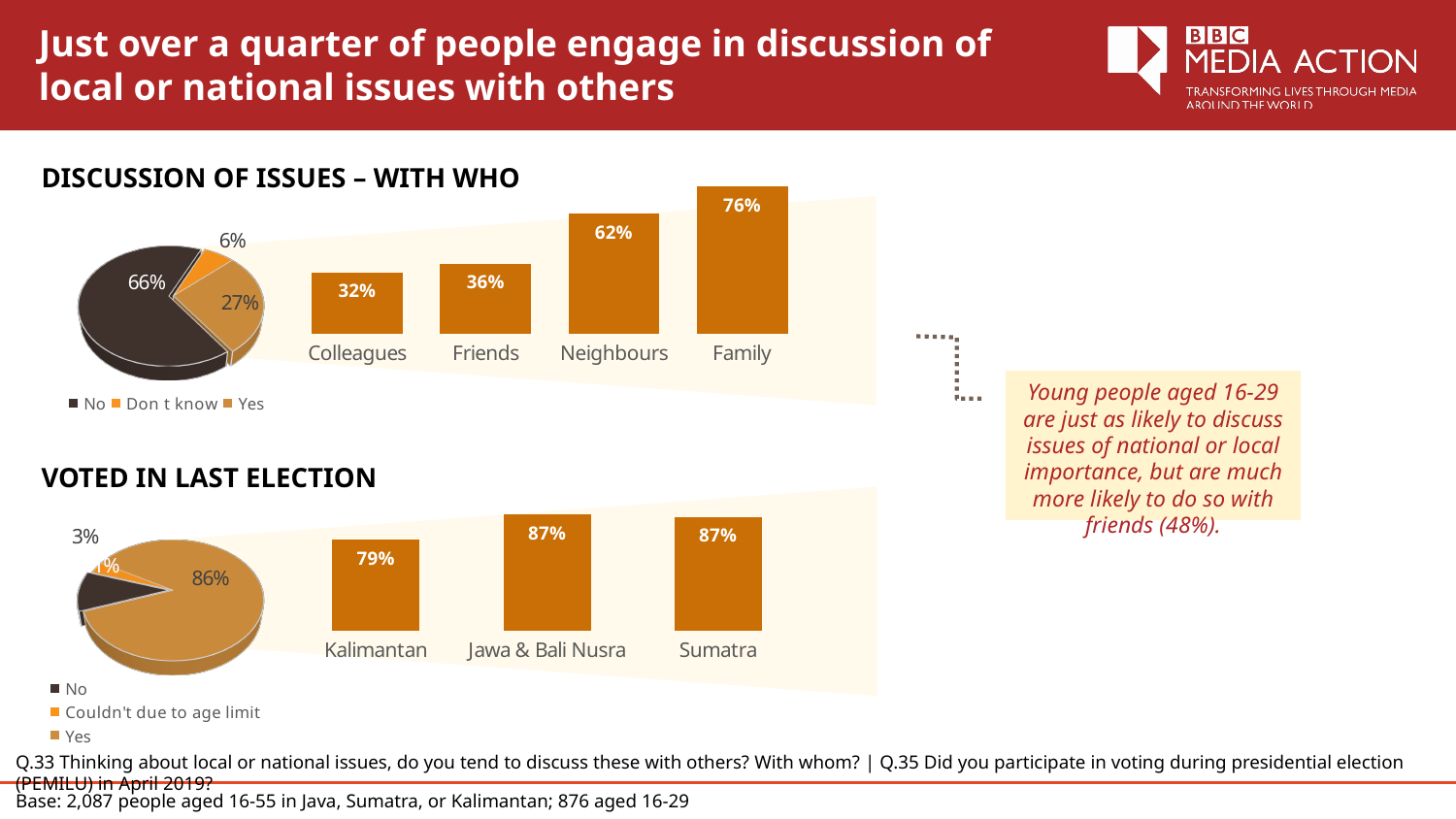
In the 'Discussion of issues – with who' bar chart, what is the value for Colleagues? 32% In the 'Discussion of issues – with who' bar chart, which category has the lowest value? Colleagues In the 'Voted in last election' bar chart, what is the value for Kalimantan? 79% In the 'Discussion of issues – with who' pie chart, what share of the pie is 'No'? 66% In the 'Discussion of issues – with who' bar chart, how many categories are shown? 4 In the 'Voted in last election' pie chart, what share of the pie is 'Yes'? 86% In the 'Discussion of issues – with who' bar chart, what is the difference between Neighbours and Friends? 26% How many entries does the legend of the 'Voted in last election' pie chart list? 3 In the 'Discussion of issues – with who' pie chart, what share of the pie is 'Yes'? 27% In the 'Discussion of issues – with who' bar chart, which category has the highest value? Family In the 'Voted in last election' bar chart, which is larger, Sumatra or Kalimantan? Sumatra In the 'Discussion of issues – with who' bar chart, what is the value for Family? 76%